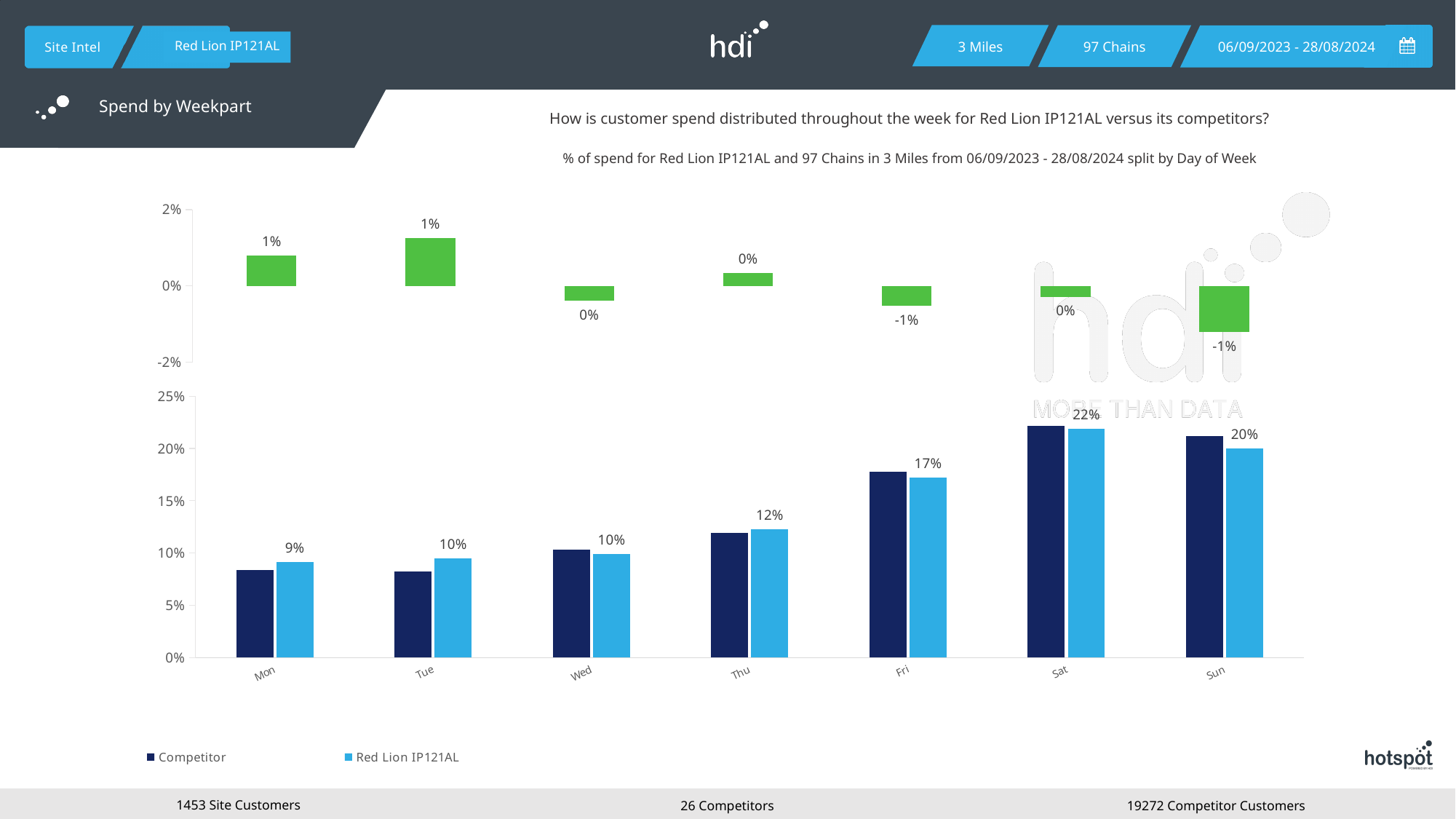
In the bottom chart, what is the value labelled for Red Lion IP121AL on Sat? 22% In the bottom chart, is the Competitor value for Sat greater or less than 20%? greater In the bottom chart, which day has the lowest labelled value for Red Lion IP121AL? Mon How many days of the week are shown on the x axis of the bottom chart? 7 In the bottom chart, which day has the highest labelled value for Red Lion IP121AL? Sat In the top green chart, what is the value labelled for Fri? -1% In the bottom chart, what is the value labelled for Red Lion IP121AL on Mon? 9% How many series does the legend of the bottom chart list? 2 In the bottom chart, is the Red Lion IP121AL value larger on Fri or on Thu? Fri In the bottom chart, what is the difference between the Red Lion IP121AL labelled values for Sat and Mon? 13% What kind of chart is the bottom chart? bar chart In the bottom chart, what is the value labelled for Red Lion IP121AL on Fri? 17%